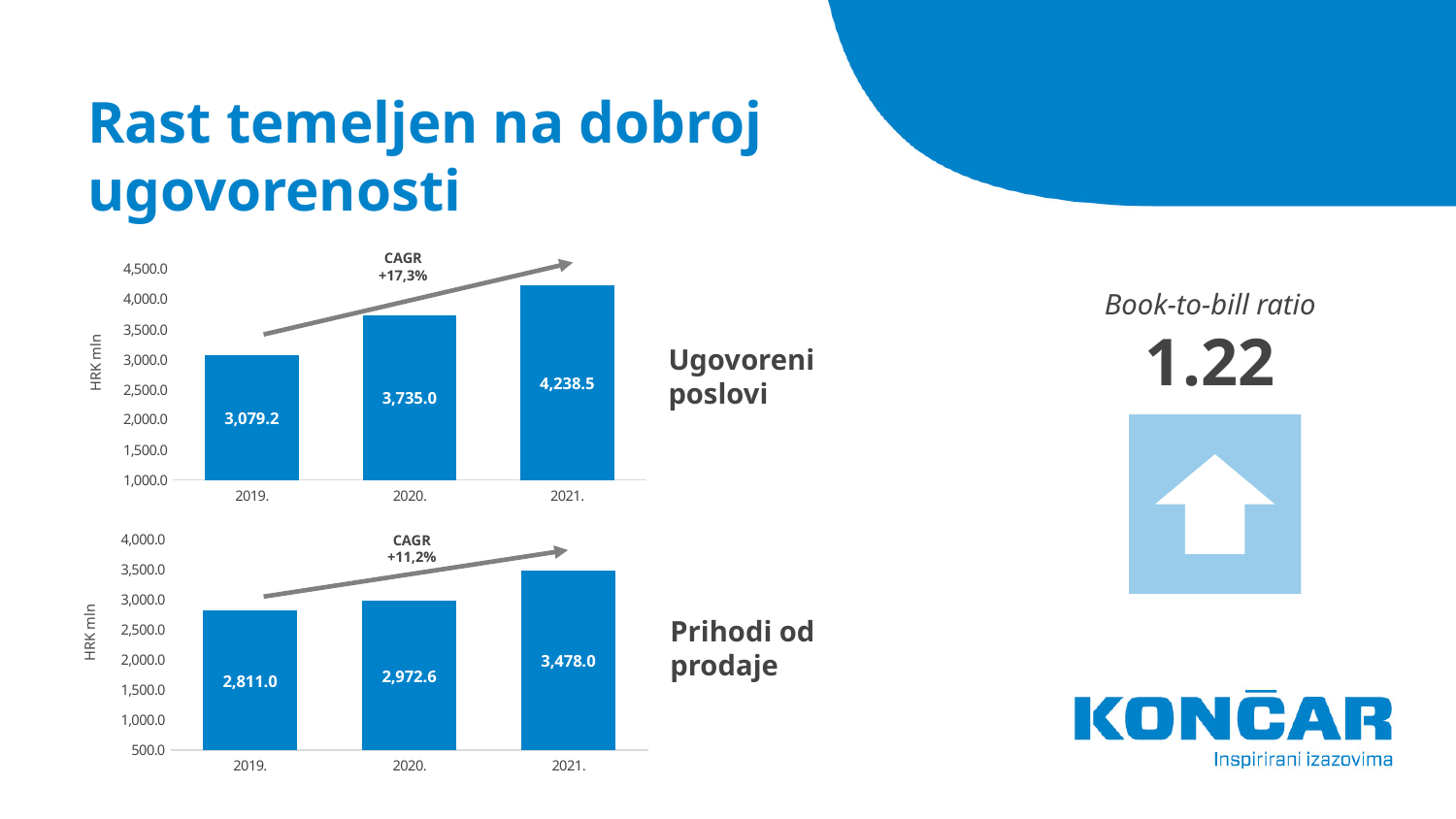
What type of chart is the top chart (Ugovoreni poslovi)? Bar chart How many years are shown on the x axis of the bottom chart (Prihodi od prodaje)? 3 In the bottom chart (Prihodi od prodaje), what is the difference between the 2020. and 2019. values? 161.6 In the top chart (Ugovoreni poslovi), which year has the lowest value? 2019. Which is larger: the 2020. value in the top chart (Ugovoreni poslovi) or the 2021. value in the bottom chart (Prihodi od prodaje)? 2020. value in the top chart (3,735.0) In the top chart (Ugovoreni poslovi), what is the difference between the 2021. and 2019. values? 1,159.3 What CAGR is shown on the top chart (Ugovoreni poslovi)? +17,3% In the top chart (Ugovoreni poslovi), what is the value for 2021.? 4,238.5 In the bottom chart (Prihodi od prodaje), do the values rise or fall from 2019. to 2021.? Rise In the bottom chart (Prihodi od prodaje), what is the value for 2019.? 2,811.0 In the bottom chart (Prihodi od prodaje), which year has the highest value? 2021. In the top chart (Ugovoreni poslovi), is the value for 2020. greater or less than 3,500.0? greater